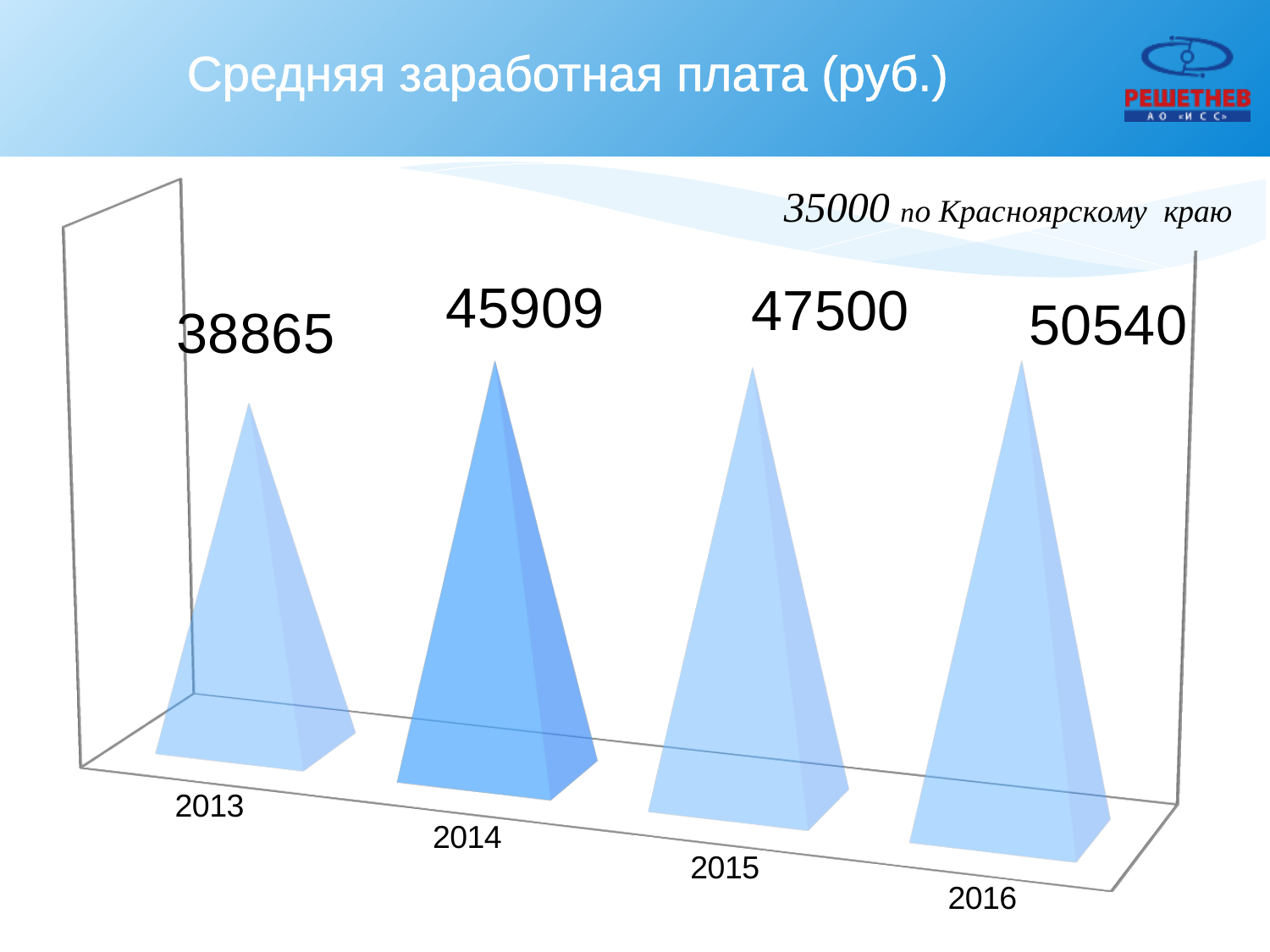
Which is larger, the value for 2014 or the value for 2015? 2015 How many years are shown on the chart? 4 Do the values rise or fall from 2013 to 2016? rise What is the difference between the 2016 and 2013 values? 11675 What is the average salary value shown for 2014? 45909 What is the average salary value shown for 2013? 38865 What is the average salary value shown for 2016? 50540 Which year has the lowest average salary? 2013 Which year has the highest average salary? 2016 What is the title of the chart? Средняя заработная плата (руб.) What is the difference between the 2015 and 2014 values? 1591 What is the average salary value shown for 2015? 47500